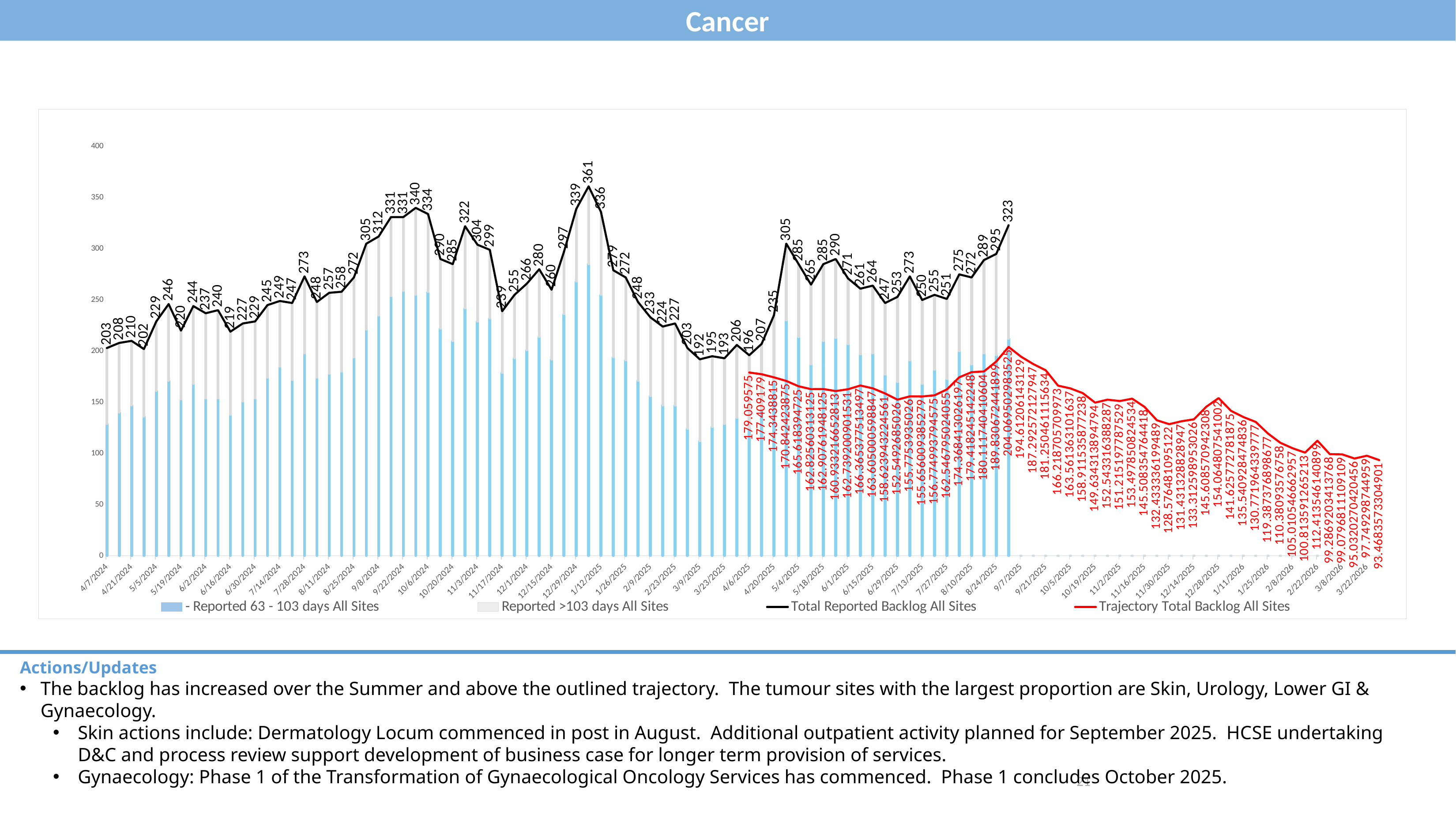
Does the Trajectory Total Backlog All Sites line rise or fall from 9/7/2025 to 3/22/2026? Fall What is the lowest value shown on the Total Reported Backlog All Sites line? 192 How many series does the legend list? 4 What is the difference between the highest (361) and lowest (192) values on the Total Reported Backlog All Sites line? 169 What kind of chart is shown on the slide? Combination bar and line chart What is the Total Reported Backlog All Sites value at 4/7/2024, the first point on the chart? 203 What is the highest value shown on the Total Reported Backlog All Sites line? 361 Which series is drawn as the red line? Trajectory Total Backlog All Sites